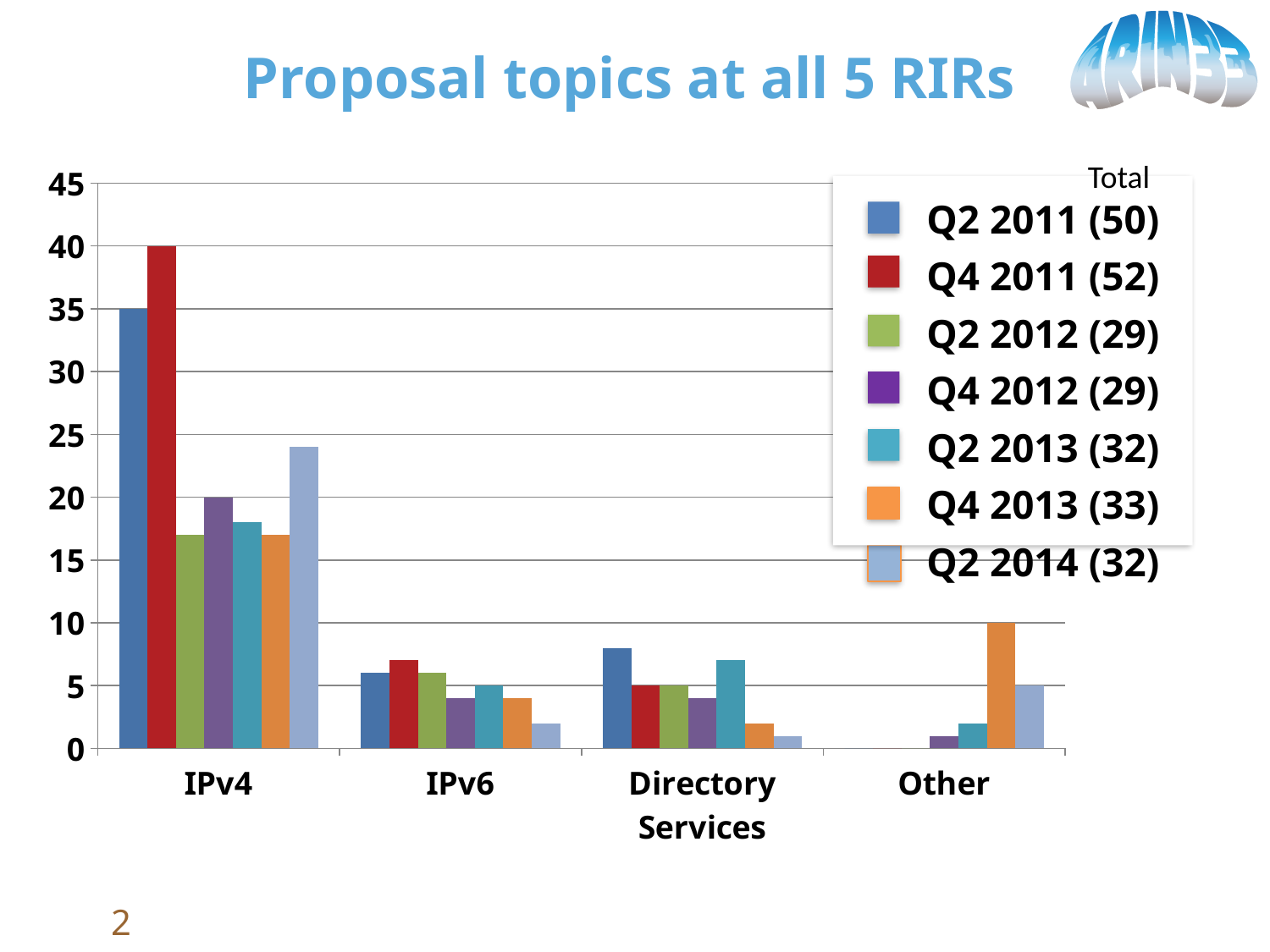
Is the value for Q2 2011 in the Directory Services category greater or less than 10? less Which series has the highest value in the Other category? Q4 2013 What is the value for Q4 2011 in the IPv4 category? 40 What kind of chart is shown on the slide? bar chart How many series does the legend list? 7 Is the value for Q2 2014 in the IPv4 category greater or less than 20? greater Which is larger in the IPv6 category, Q4 2011 or Q2 2014? Q4 2011 What total is shown in the legend for Q4 2011? 52 What is the value for Q4 2013 in the Other category? 10 How many categories are shown on the x axis? 4 Which series has the highest value in the IPv4 category? Q4 2011 What is the value for Q2 2011 in the IPv4 category? 35